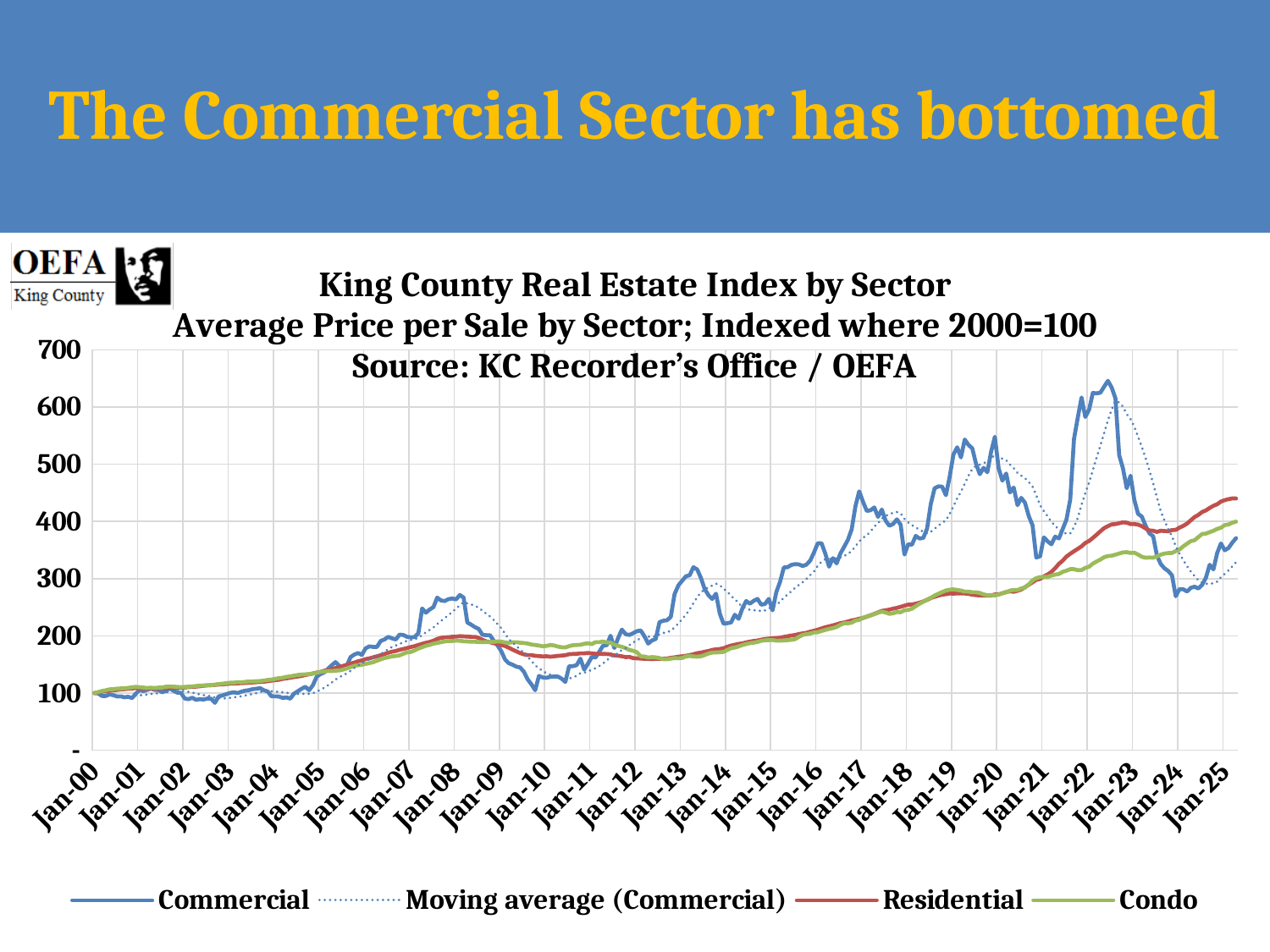
Which series is drawn as a dotted line? Moving average (Commercial) How many series does the chart legend list? 4 Does the Residential series rise or fall overall from Jan-00 to Jan-25? Rise What is the base year and value for the index according to the chart title? 2000=100 Does the Commercial series rise or fall from its peak around Jan-22 to Jan-24? Fall At Jan-24, which series has the higher value, Residential or Commercial? Residential Is the value of the Residential series at Jan-25 greater or less than 400? greater Is the peak value of the Commercial series around Jan-22 greater or less than 600? greater Is the value of the Commercial series at Jan-10 greater or less than 200? less Which series reaches the highest value anywhere on the chart? Commercial What kind of chart is shown on the slide? Line chart